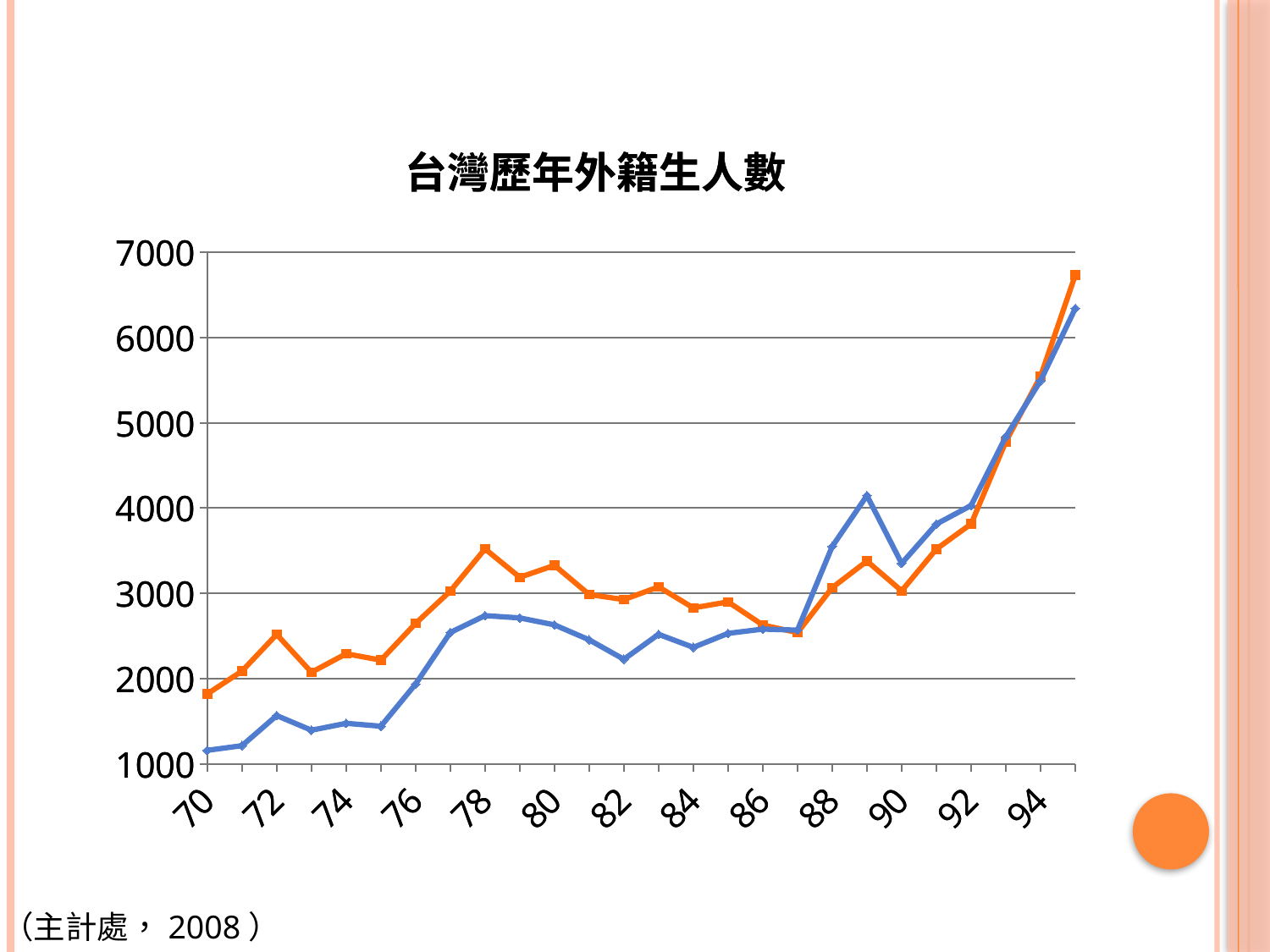
Is the value of the blue line at the last point (95) greater or less than 6000? greater At 70, which line has the higher value, the orange line or the blue line? orange line How many lines (series) are plotted on the chart? 2 What is the title of the chart? 台灣歷年外籍生人數 Is the value of the orange line at 94 greater or less than 5000? greater At 89, which line has the higher value, the orange line or the blue line? blue line Overall, do the values rise or fall from 70 to 95? rise Is the value of the orange line at 70 greater or less than 2000? less What kind of chart is shown on the slide? line chart